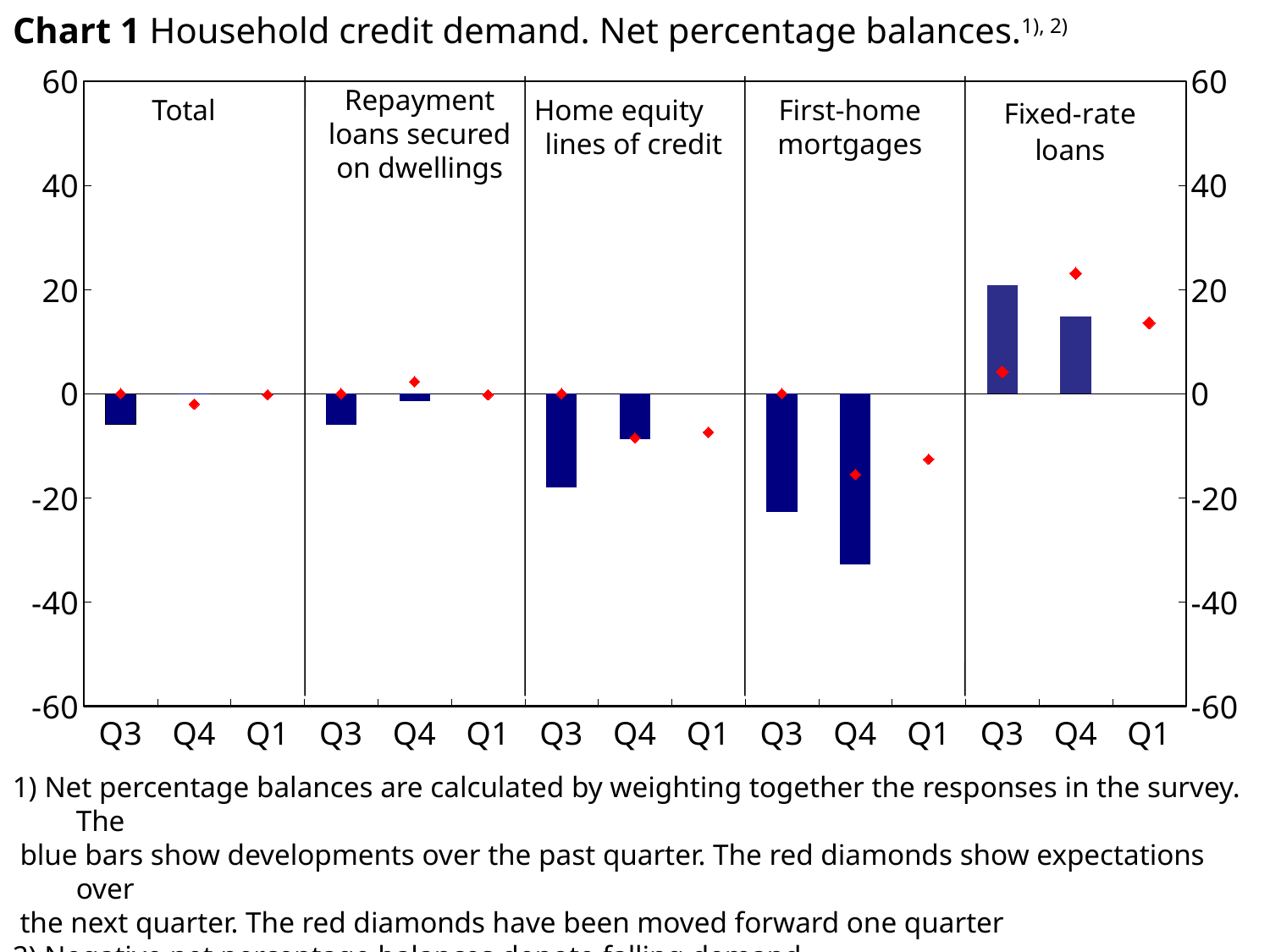
Which category and quarter has the lowest (most negative) blue bar in Chart 1? First-home mortgages, Q4 For First-home mortgages, which blue bar is lower, Q3 or Q4? Q4 What kind of chart is Chart 1? combination chart (bars with red diamond markers) Is the Q4 blue bar for First-home mortgages greater or less than -20? less For Fixed-rate loans, which blue bar is larger, Q3 or Q4? Q3 How many credit categories (panels) are shown in Chart 1? 5 Which category in Chart 1 is the only one with positive blue bars? Fixed-rate loans Is the Q3 blue bar for Home equity lines of credit greater or less than -20? greater Which category and quarter has the highest blue bar in Chart 1? Fixed-rate loans, Q3 How many quarters are shown on the x axis within each panel of Chart 1? 3 According to the footnote, what do the red diamonds in Chart 1 show? Expectations over the next quarter Is the Q4 blue bar for Fixed-rate loans greater or less than 20? less